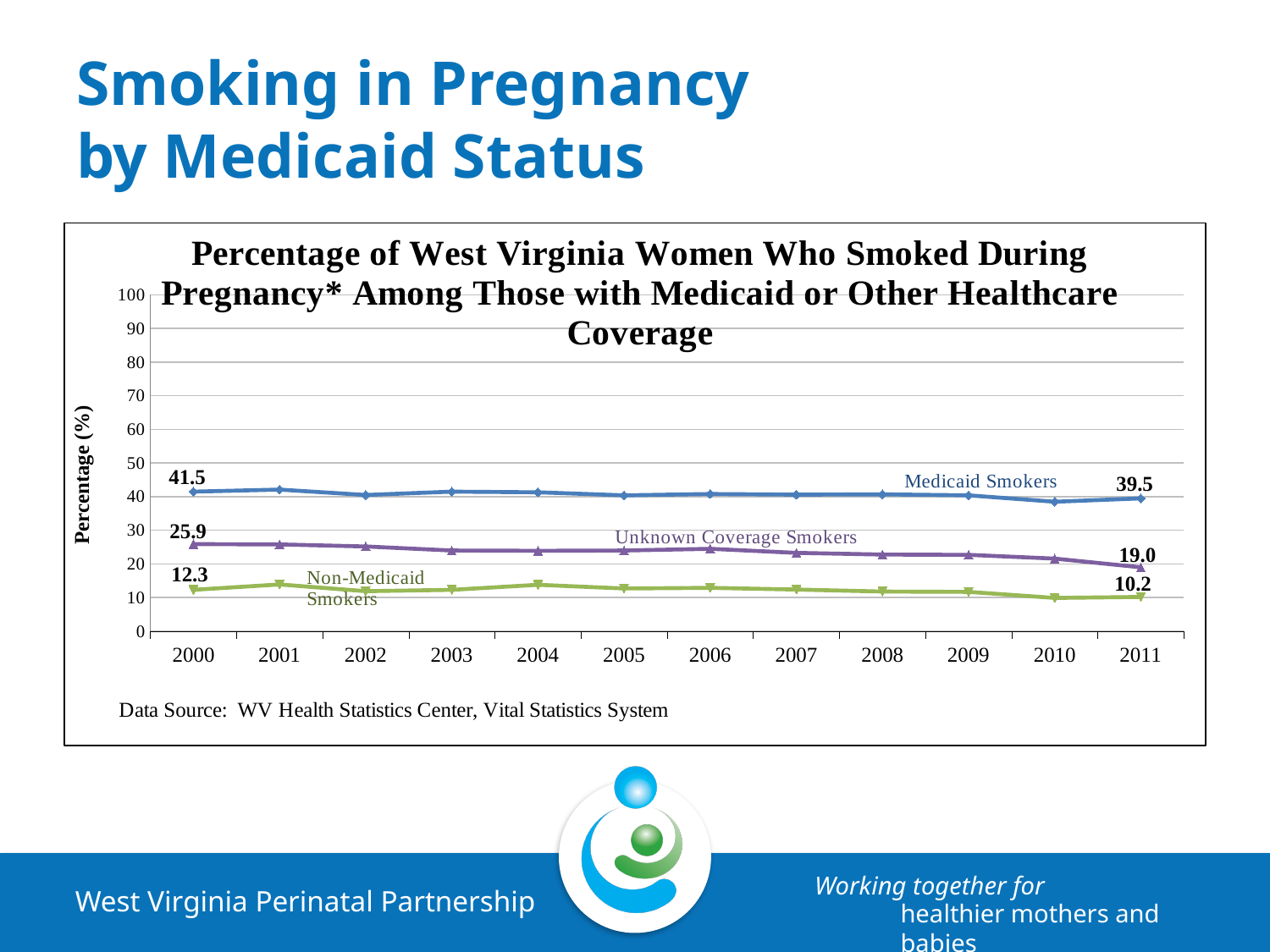
By how much did the percentage of Unknown Coverage smokers fall from 2000 to 2011? 6.9 What was the percentage of Medicaid smokers in 2011? 39.5 Which group had the lowest smoking percentage in 2000? Non-Medicaid Smokers What type of chart is shown on the slide? Line chart What is the difference between the Medicaid smokers and Non-Medicaid smokers percentages in 2000? 29.2 How many years are shown on the x axis? 12 What was the percentage of Medicaid smokers in 2000? 41.5 Is the value for Medicaid smokers in 2005 greater or less than 50? less What was the percentage of Unknown Coverage smokers in 2011? 19.0 What was the percentage of Unknown Coverage smokers in 2000? 25.9 What was the percentage of Non-Medicaid smokers in 2011? 10.2 Which group had the highest smoking percentage in 2011? Medicaid Smokers